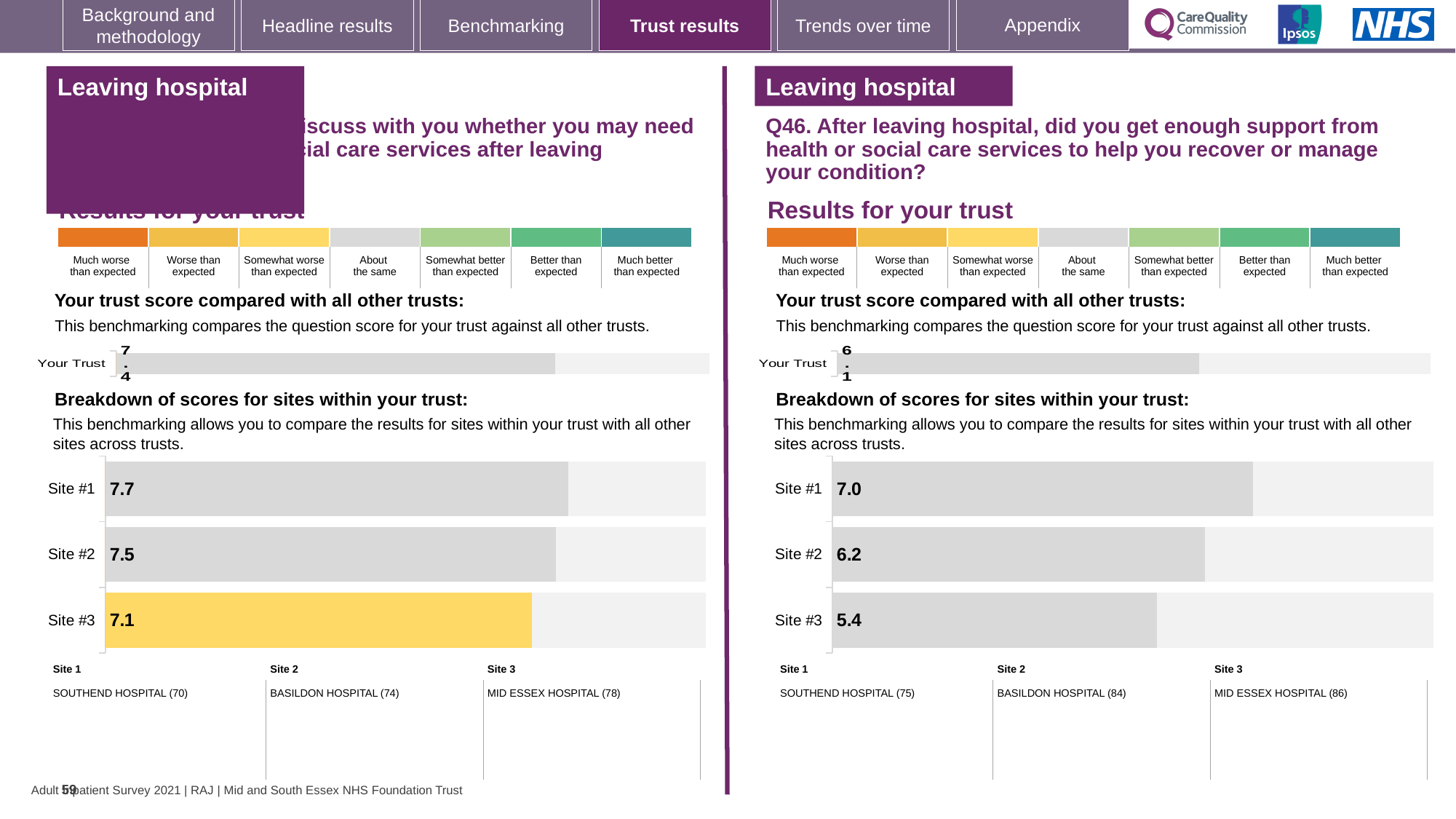
Which is larger: the Site #2 score on the left-hand breakdown chart or the Site #2 score on the right-hand (Q46) breakdown chart? Left-hand chart (7.5) On the right-hand (Q46) 'Breakdown of scores for sites within your trust' chart, what is the score for Site #2? 6.2 On the left-hand 'Breakdown of scores for sites within your trust' chart, what is the score for Site #1? 7.7 On the right-hand (Q46) 'Breakdown of scores for sites within your trust' chart, what is the difference between the scores for Site #1 and Site #3? 1.6 What type of chart is used for the 'Breakdown of scores for sites within your trust' on the left-hand side? Bar chart On the right-hand (Q46) 'Breakdown of scores for sites within your trust' chart, which site has the lowest score? Site #3 On the left-hand 'Your trust score compared with all other trusts' chart, what is the score for Your Trust? 7.4 On the left-hand 'Breakdown of scores for sites within your trust' chart, which site has the highest score? Site #1 On the left-hand 'Breakdown of scores for sites within your trust' chart, what is the difference between the scores for Site #1 and Site #2? 0.2 On the left-hand 'Breakdown of scores for sites within your trust' chart, what is the score for Site #3? 7.1 On the right-hand (Q46) 'Your trust score compared with all other trusts' chart, what is the score for Your Trust? 6.1 How many sites are shown on the right-hand (Q46) 'Breakdown of scores for sites within your trust' chart? 3